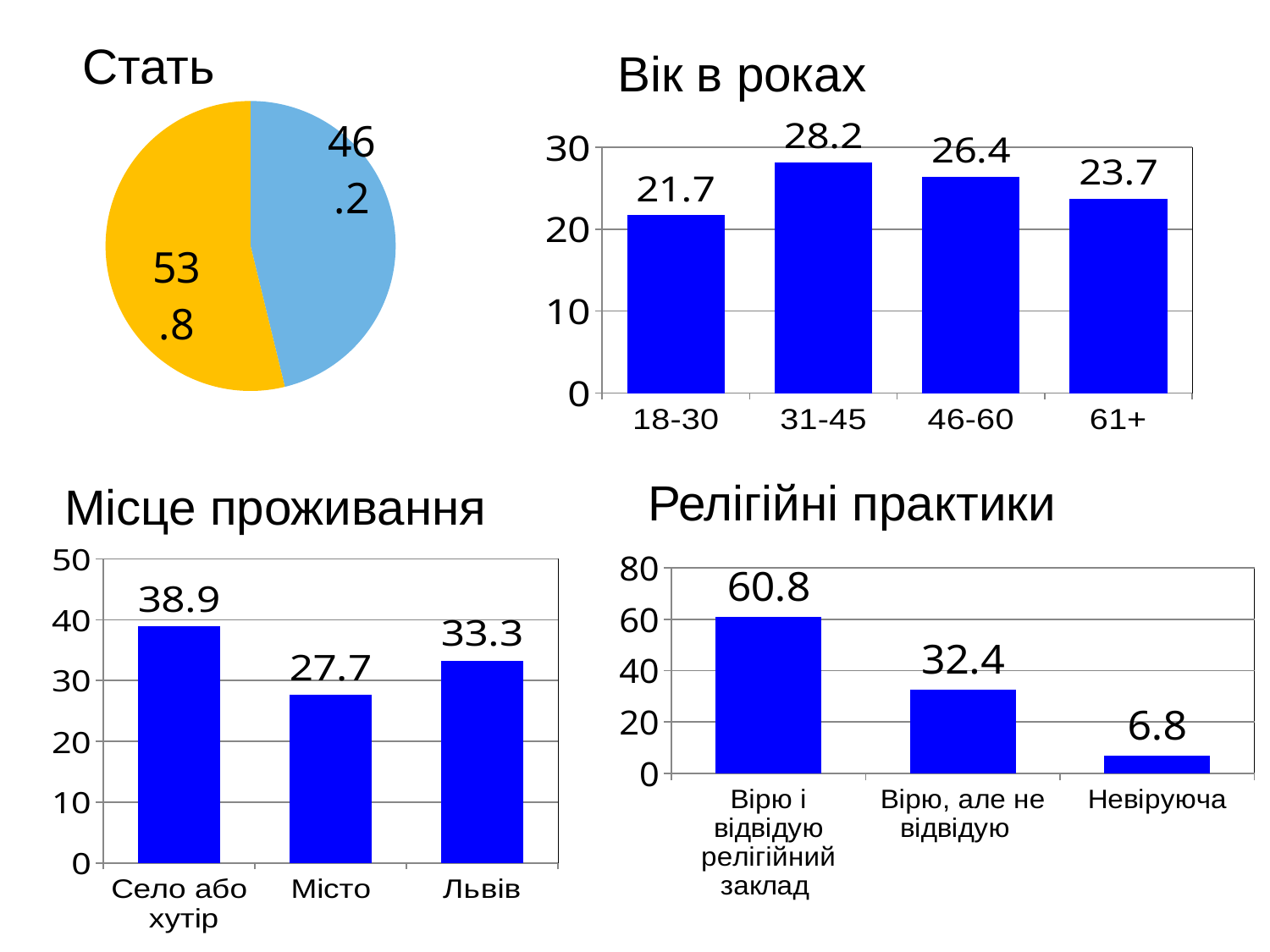
In the "Місце проживання" chart, which is larger: the value for Місто or the value for Львів? Львів In the "Вік в роках" chart, what is the value for the 31-45 age group? 28.2 In the "Релігійні практики" chart, what is the value for "Невіруюча"? 6.8 In the "Релігійні практики" chart, what is the difference between the values for "Вірю і відвідую релігійний заклад" and "Вірю, але не відвідую"? 28.4 In the "Вік в роках" chart, which age group has the lowest value? 18-30 In the "Вік в роках" chart, how many age groups are shown? 4 What kind of chart is the "Релігійні практики" chart? Bar chart In the "Вік в роках" chart, what is the difference between the values for 46-60 and 61+? 2.7 In the "Стать" pie chart, what value is shown on the orange slice? 53.8 In the "Місце проживання" chart, which category has the highest value? Село або хутір In the "Місце проживання" chart, what is the value for Львів? 33.3 What kind of chart is the "Стать" chart? Pie chart